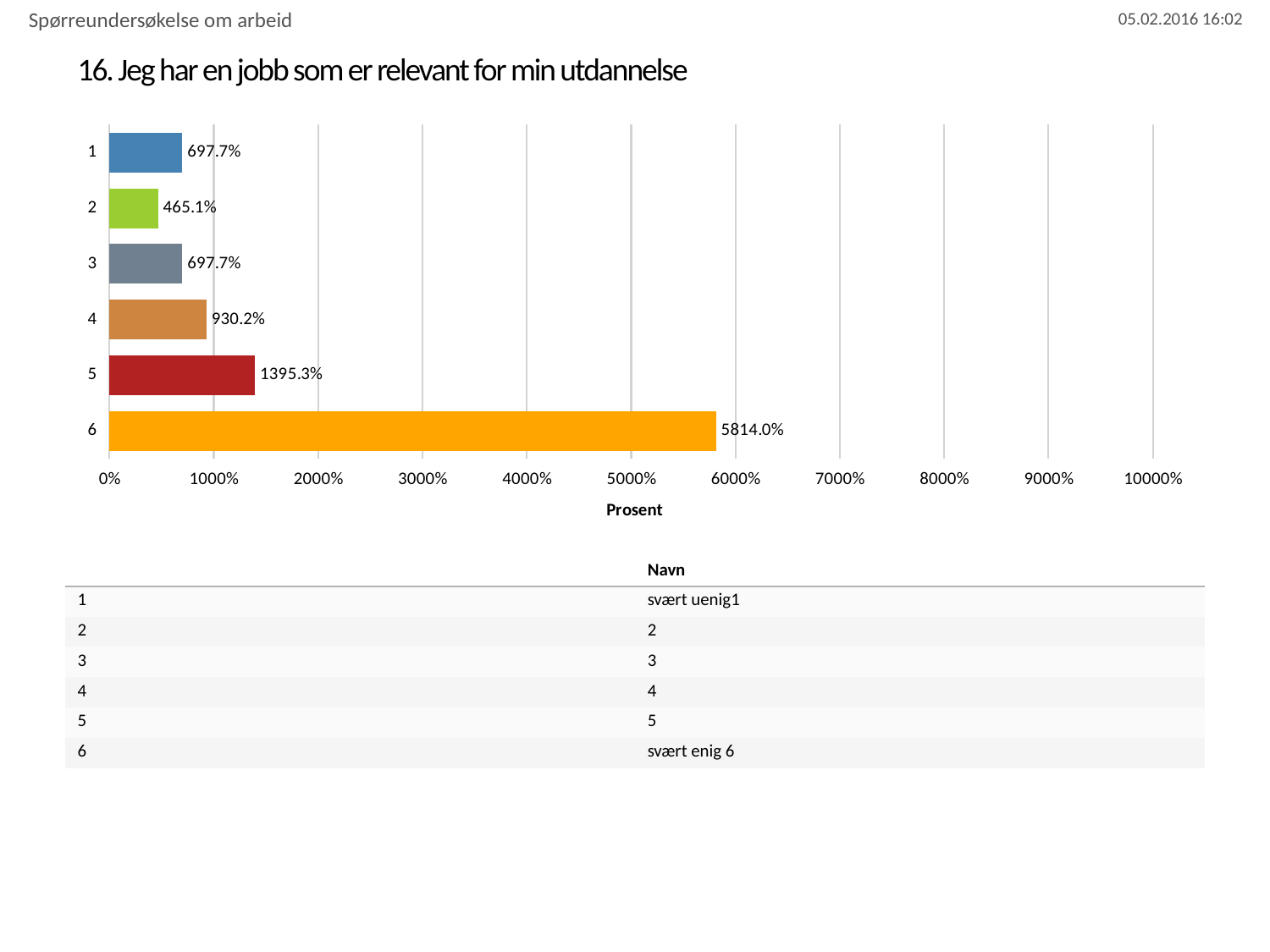
Which category has the highest value? 6 What is the difference between the values for category 6 and category 5? 4418.7% What is the value for category 6? 5814.0% What is the value for category 2? 465.1% Is the value for category 5 greater or less than 1000%? greater What is the difference between the values for category 4 and category 2? 465.1% What kind of chart is shown on the slide? bar chart What is the value for category 4? 930.2% Which category has the lowest value? 2 How many categories are shown in the chart? 6 Which is larger, the value for category 4 or the value for category 3? 4 What is the value for category 5? 1395.3%